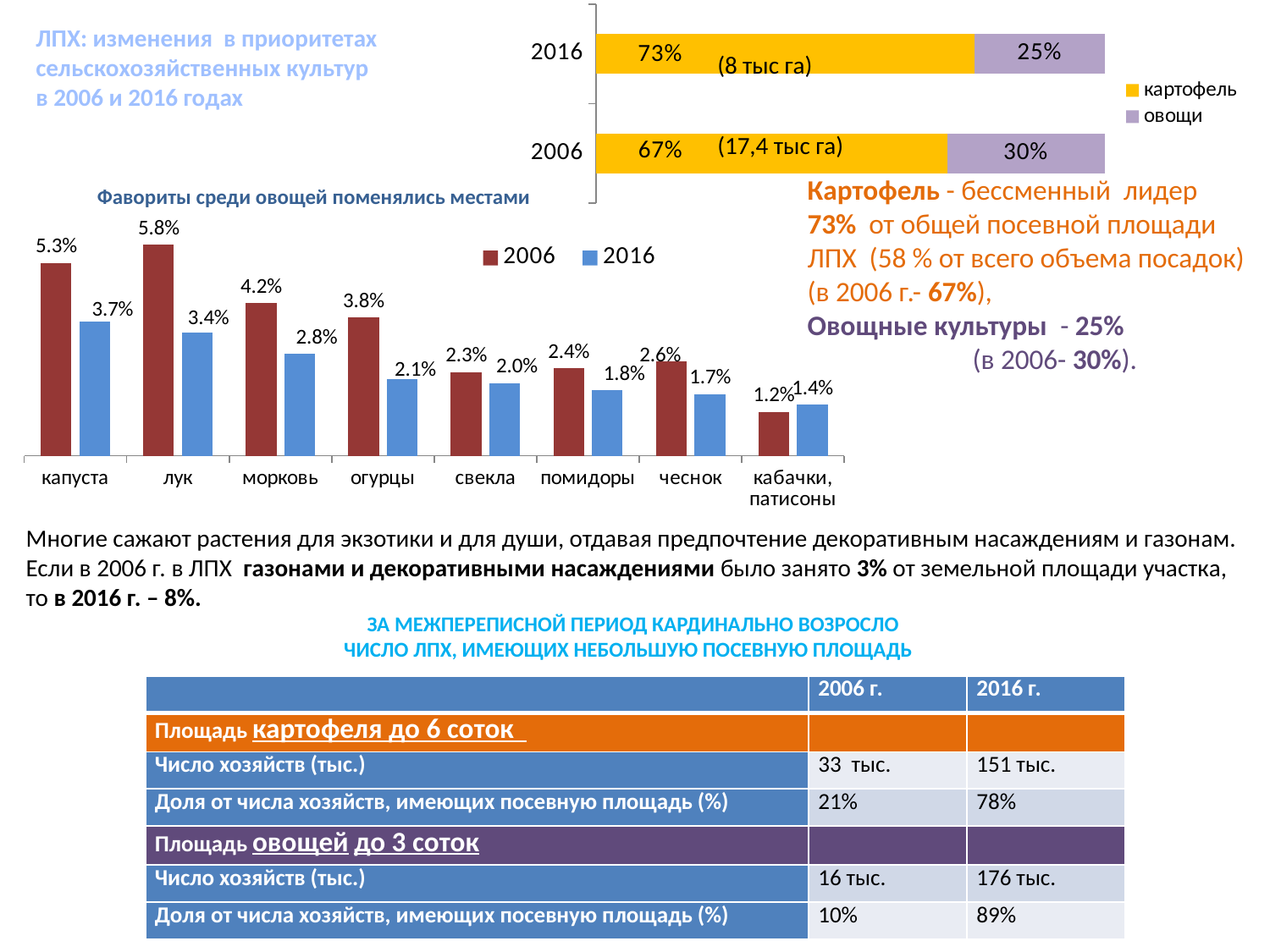
In the chart 'Фавориты среди овощей поменялись местами', what is the difference between the 2006 and 2016 values for морковь? 1.4% In the stacked bar chart at the top of the slide, what is the share of овощи in 2006? 30% In the stacked bar chart at the top of the slide, what is the share of картофель in 2016? 73% In the stacked bar chart at the top of the slide, how many series does the legend list? 2 In the chart 'Фавориты среди овощей поменялись местами', how many categories are shown on the x axis? 8 In the chart 'Фавориты среди овощей поменялись местами', what is the value for лук in 2006? 5.8% In the stacked bar chart at the top of the slide, by how many percentage points did the share of картофель change from 2006 to 2016? 6 percentage points In the chart 'Фавориты среди овощей поменялись местами', which is larger for кабачки, патисоны: the 2006 value or the 2016 value? 2016 In the chart 'Фавориты среди овощей поменялись местами', which category has the highest value in 2016? капуста What type of chart is 'Фавориты среди овощей поменялись местами'? bar chart In the chart 'Фавориты среди овощей поменялись местами', which category has the lowest value in 2006? кабачки, патисоны In the chart 'Фавориты среди овощей поменялись местами', what is the value for капуста in 2016? 3.7%